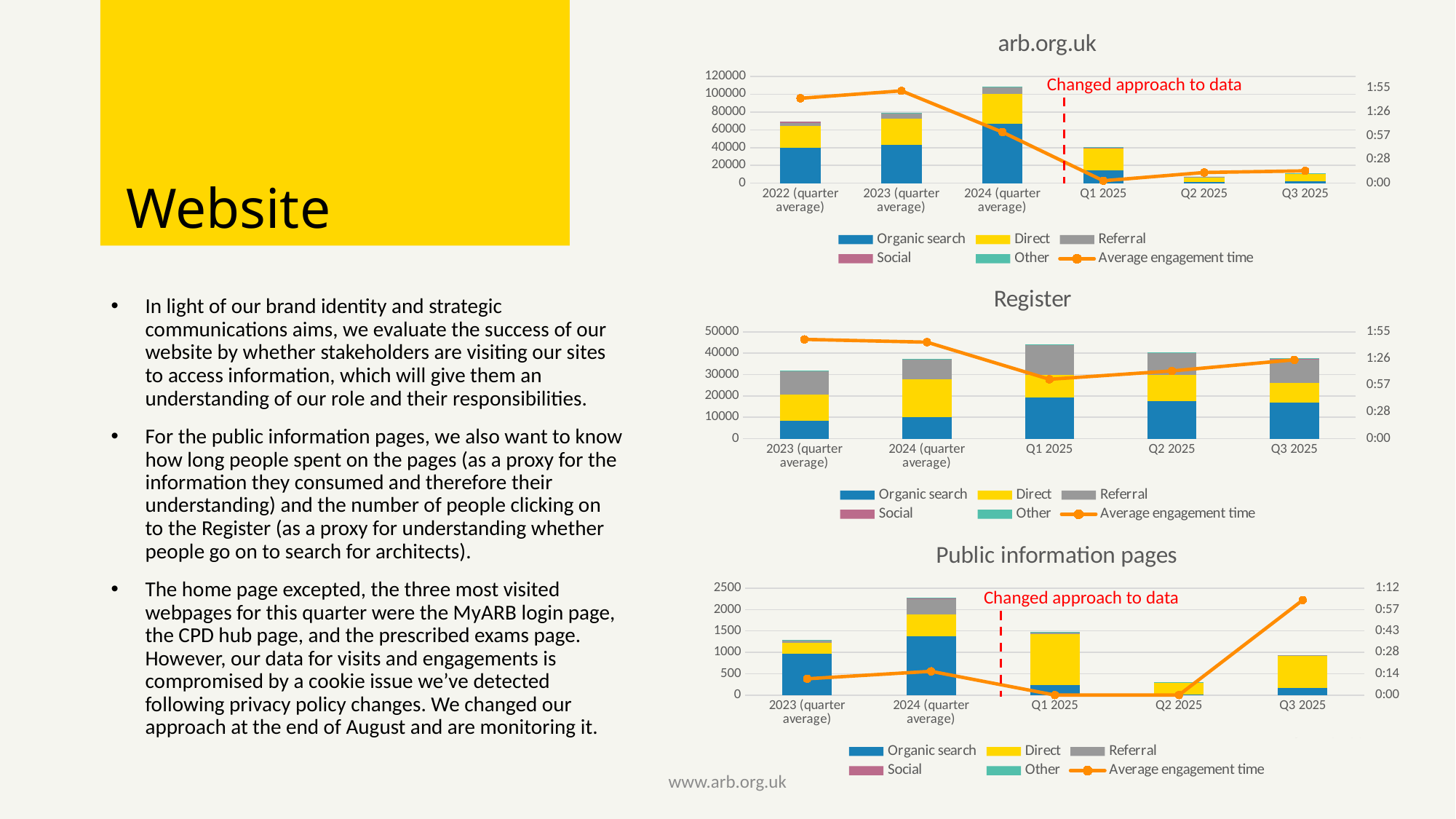
In the 'arb.org.uk' chart, is the total bar for 2024 (quarter average) greater or less than 100000? greater How many categories are shown on the x axis of the 'arb.org.uk' chart? 6 In the 'arb.org.uk' chart, which category has the tallest stacked bar? 2024 (quarter average) In the 'Register' chart, which category has the tallest stacked bar? Q1 2025 In the 'Register' chart, which category has the shortest stacked bar? 2023 (quarter average) In the 'Register' chart, is the Organic search value for 2023 (quarter average) greater or less than 10000? less In the 'Public information pages' chart, is the total bar for 2024 (quarter average) greater or less than 2000? greater In the 'Public information pages' chart, does the Average engagement time line rise or fall from Q2 2025 to Q3 2025? rise How many series does the legend of the 'Register' chart list? 6 In the 'Public information pages' chart, which category has the shortest stacked bar? Q2 2025 What kind of chart is the 'arb.org.uk' chart? Stacked bar chart with a line